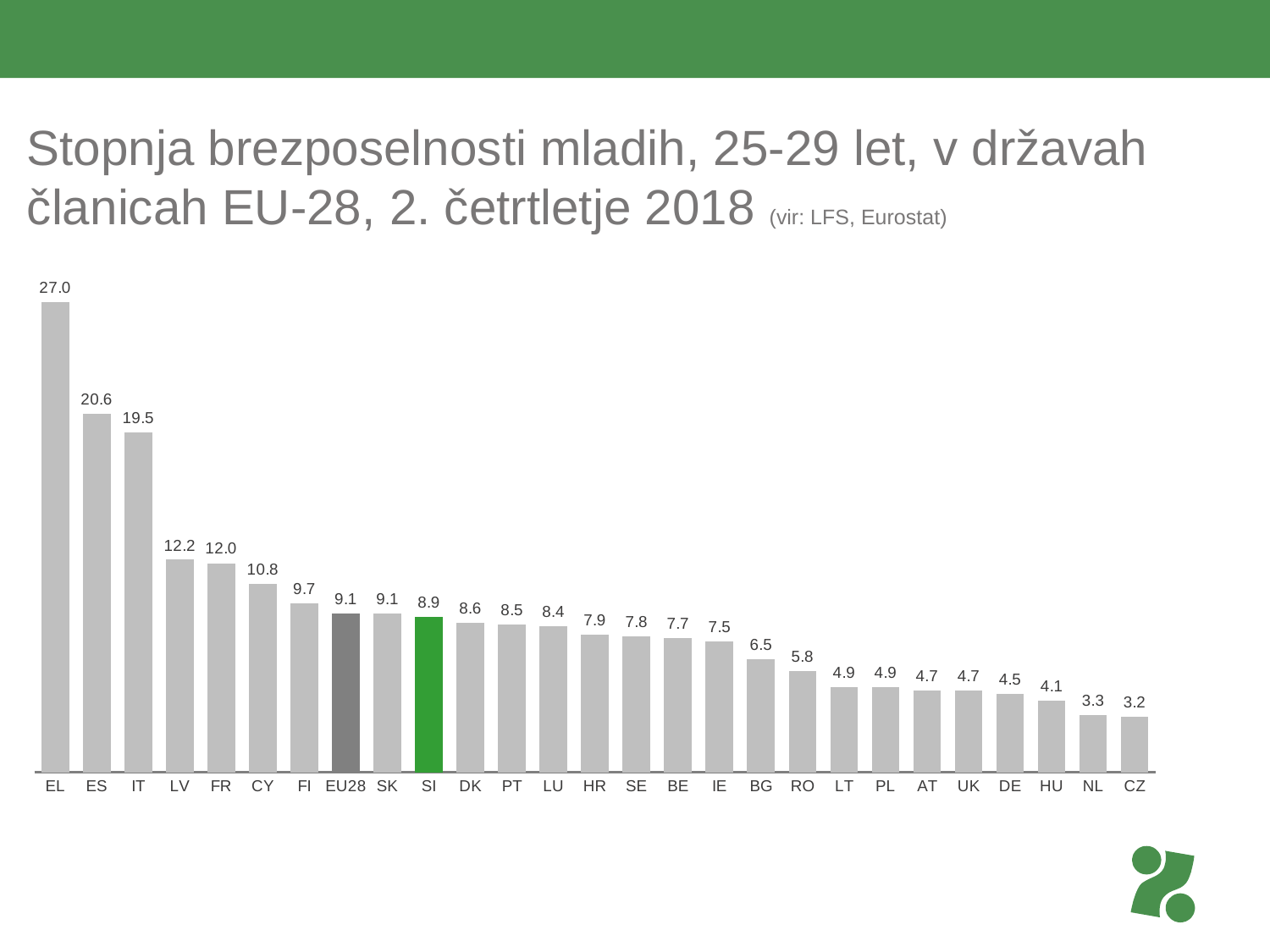
What is the value for EL? 27.0 What is the value for CZ? 3.2 Which country has the highest value? EL Which bar is coloured green? SI How many bars are shown in the chart? 27 Which country has the lowest value? CZ What is the difference between the values for ES and IT? 1.1 What is the value for EU28? 9.1 What kind of chart is shown on the slide? bar chart Which is larger, the value for LV or the value for CY? LV What is the value for SI? 8.9 What is the difference between the values for EU28 and SI? 0.2